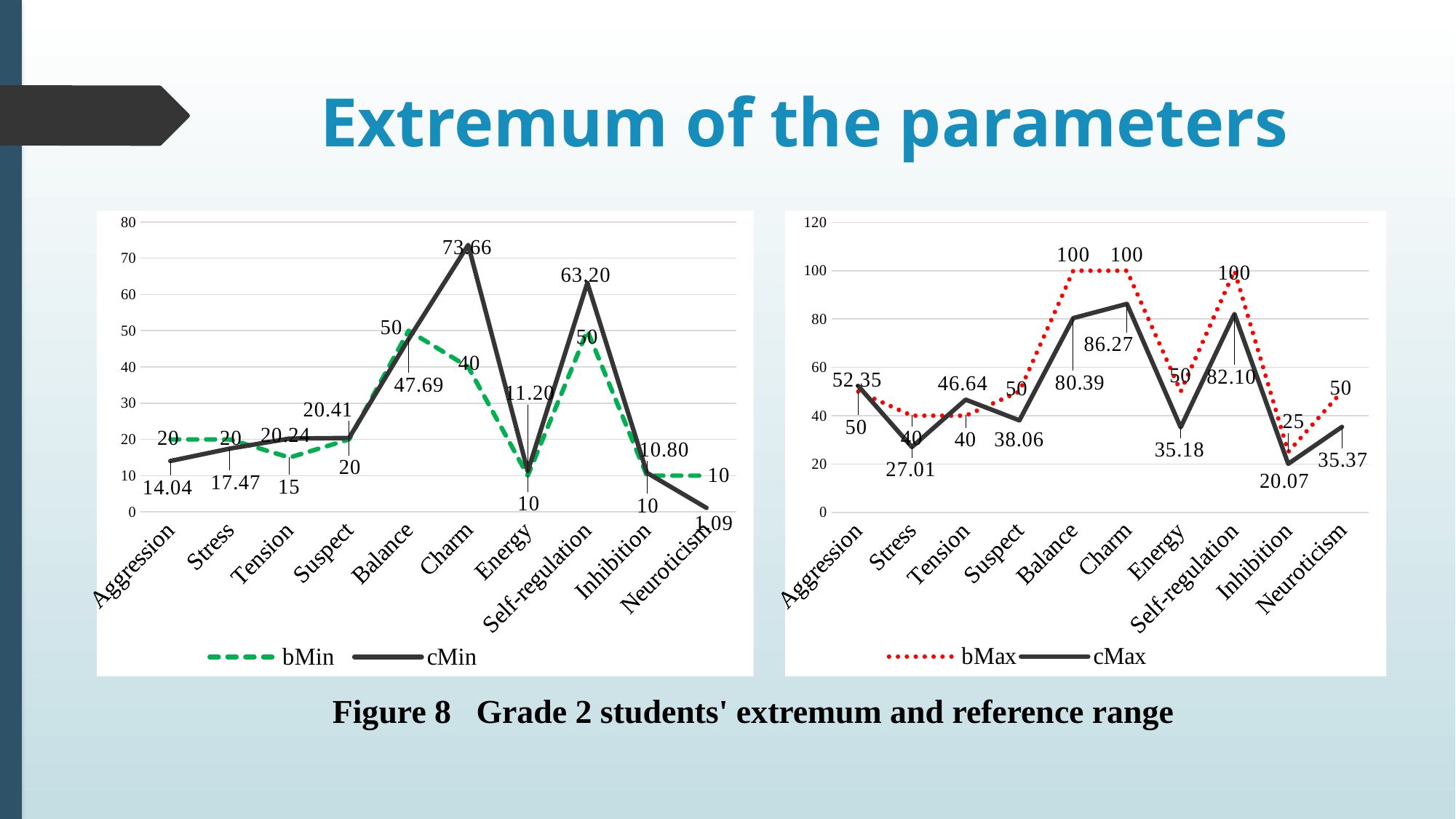
On the right chart, what is the cMax value for Inhibition? 20.07 On the right chart, what is the cMax value for Charm? 86.27 On the right chart, which category has the lowest cMax value? Inhibition On the left chart, what is the cMin value for Neuroticism? 1.09 On the right chart, what is the difference between the bMax and cMax values for Balance? 19.61 On the left chart, which is larger for Self-regulation: the bMin value or the cMin value? cMin On the left chart, what is the cMin value for Charm? 73.66 How many categories are shown on the x axis of the right chart? 10 On the left chart, what is the bMin value for Balance? 50 How many series does the legend of the left chart list? 2 On the left chart, which category has the highest cMin value? Charm What type of chart is the right chart? Line chart